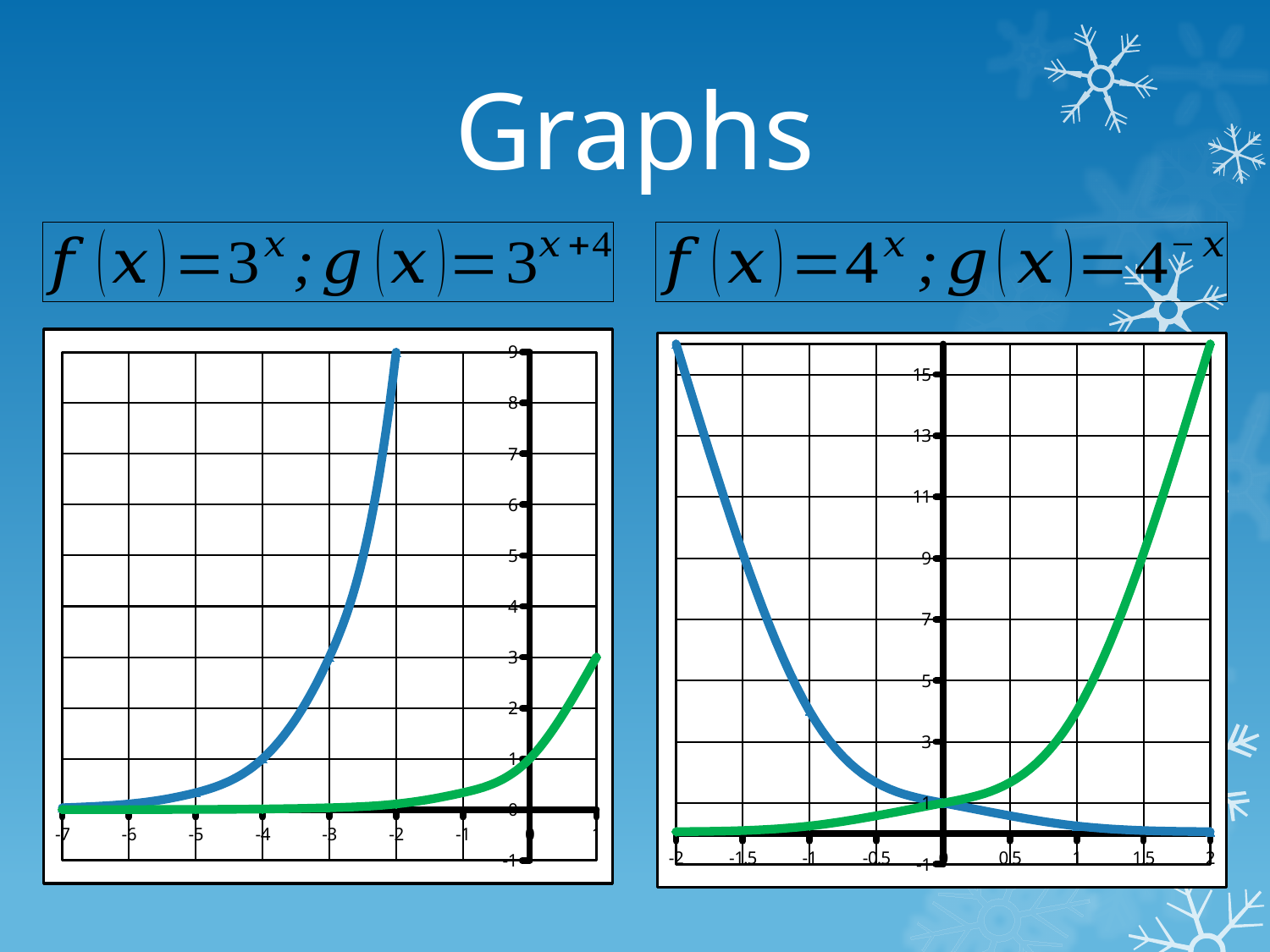
How many curves are plotted on the right chart (f(x)=4^x; g(x)=4^(-x))? 2 On the right chart, is the value of the blue curve at x = 1 greater or less than 1? less On the right chart, does the blue curve rise or fall as x increases? fall On the left chart, does the green curve rise or fall as x increases? rise On the left chart, is the value of the green curve at x = -1 greater or less than 1? less What is the lowest x-axis label shown on the left chart? -7 On the left chart, at x = -2, which curve is higher, the blue one or the green one? blue On the left chart, is the value of the blue curve at x = -3 greater or less than 2? greater On the right chart, at x = 1.5, which curve is higher, the blue one or the green one? green What is the highest y-axis label shown on the right chart? 15 What kind of chart is the left chart (f(x)=3^x; g(x)=3^(x+4))? line chart